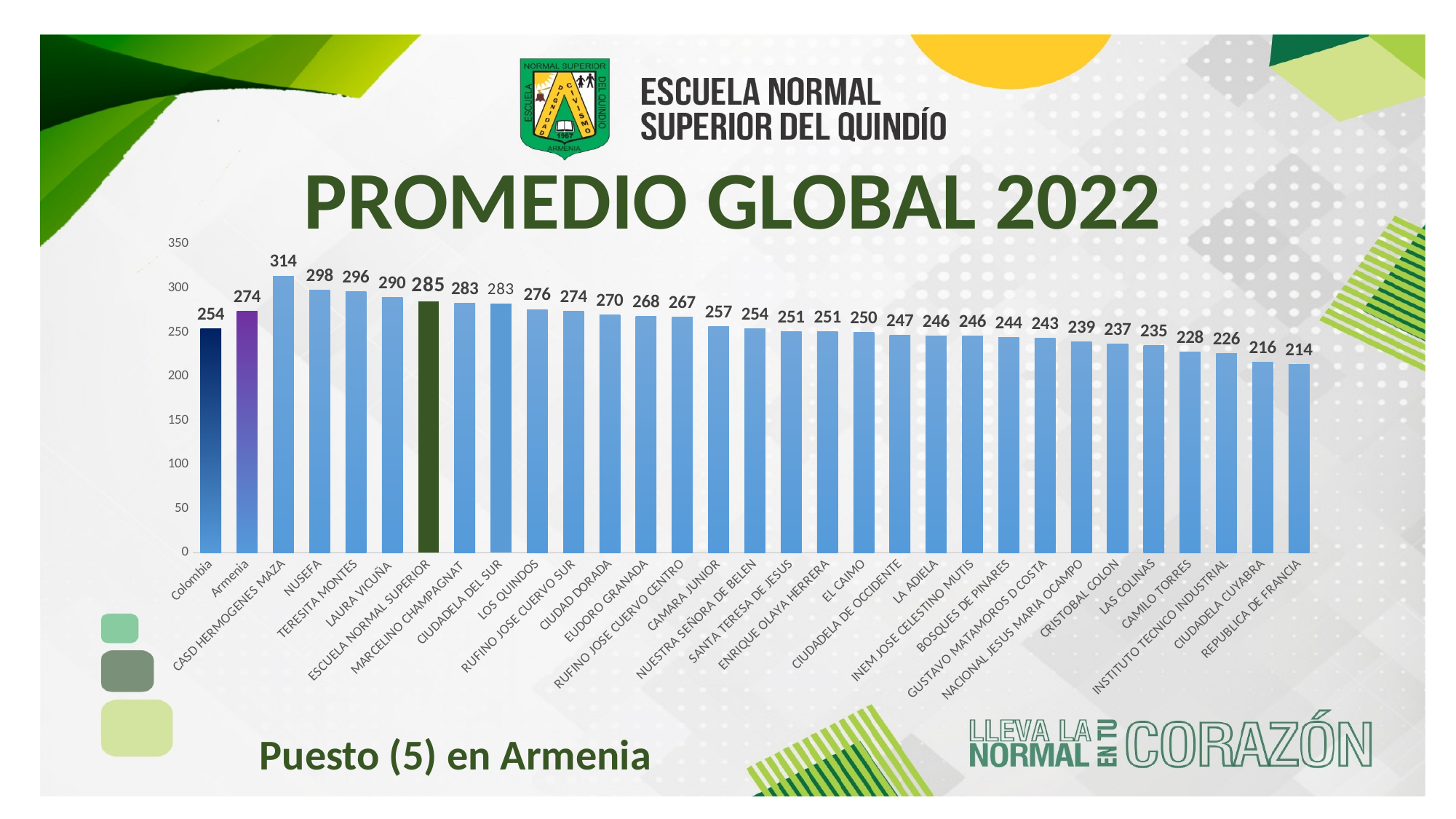
What is the value for Armenia? 274 Which category has the highest value? CASD HERMOGENES MAZA Which is larger, the value for NUSEFA or the value for TERESITA MONTES? NUSEFA What kind of chart is shown on the slide? bar chart What is the difference between the values for ESCUELA NORMAL SUPERIOR and Armenia? 11 How many categories are shown on the x axis? 31 What is the difference between the values for CASD HERMOGENES MAZA and ESCUELA NORMAL SUPERIOR? 29 What is the value for ESCUELA NORMAL SUPERIOR? 285 What is the value for Colombia? 254 Which category has the lowest value? REPUBLICA DE FRANCIA What is the value for REPUBLICA DE FRANCIA? 214 What is the title of the chart? PROMEDIO GLOBAL 2022